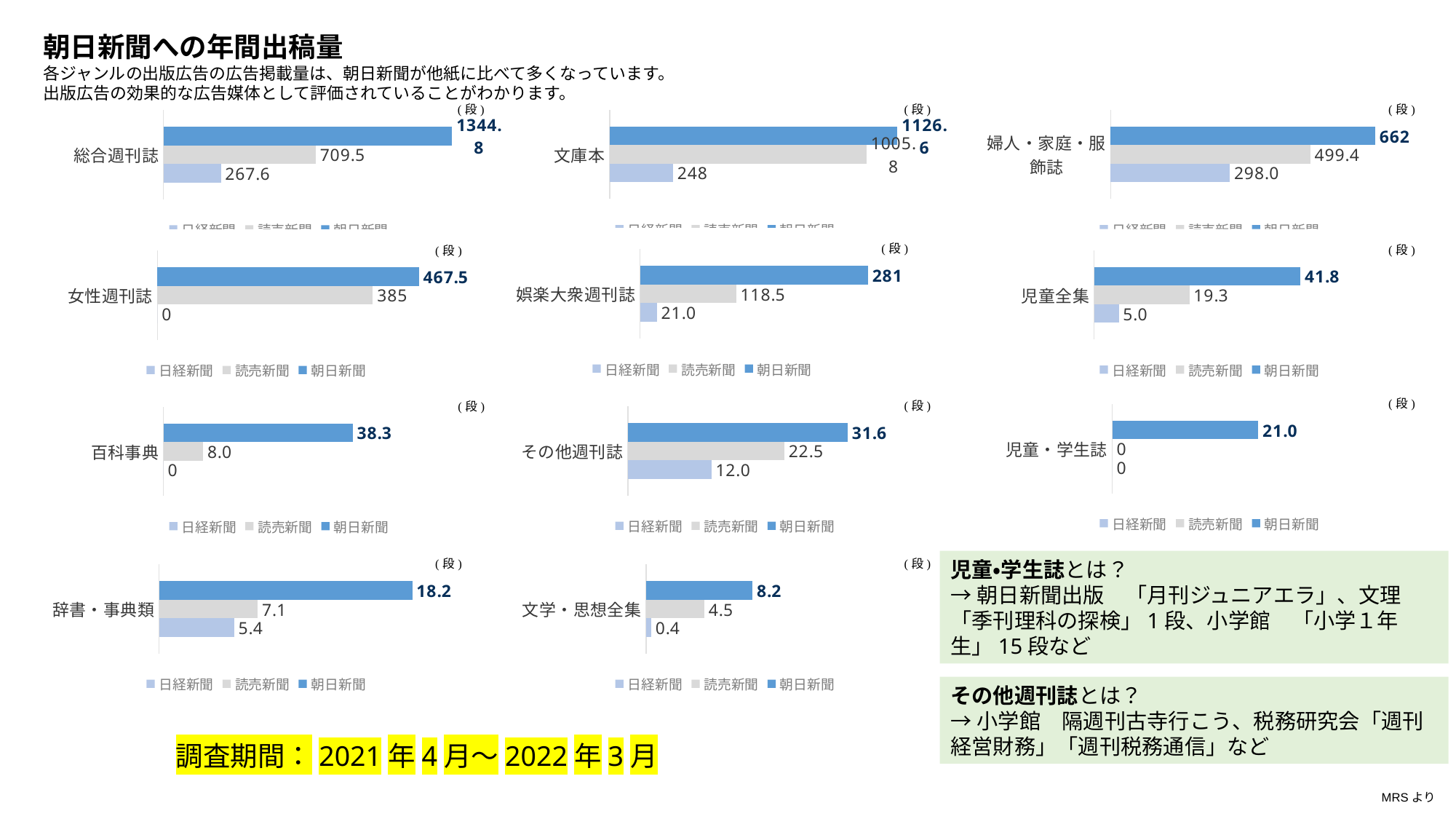
In the 女性週刊誌 chart, what is the difference between the 朝日新聞 and 読売新聞 values? 82.5 What kind of chart is the その他週刊誌 chart? Bar chart In the 総合週刊誌 chart, what is the value for 朝日新聞? 1344.8 In the 娯楽大衆週刊誌 chart, which newspaper has the highest value? 朝日新聞 In the 婦人・家庭・服飾誌 chart, what is the value for 日経新聞? 298.0 What unit is shown at the top right of each chart? 段 In the 文学・思想全集 chart, what is the difference between the 朝日新聞 and 読売新聞 values? 3.7 In the 児童全集 chart, which newspaper has the lowest value? 日経新聞 In the 文庫本 chart, what is the value for 読売新聞? 1005.8 In the 児童・学生誌 chart, what is the value for 読売新聞? 0 In the 辞書・事典類 chart, which is larger, the value for 読売新聞 or the value for 日経新聞? 読売新聞 How many series does the legend of the 百科事典 chart list? 3